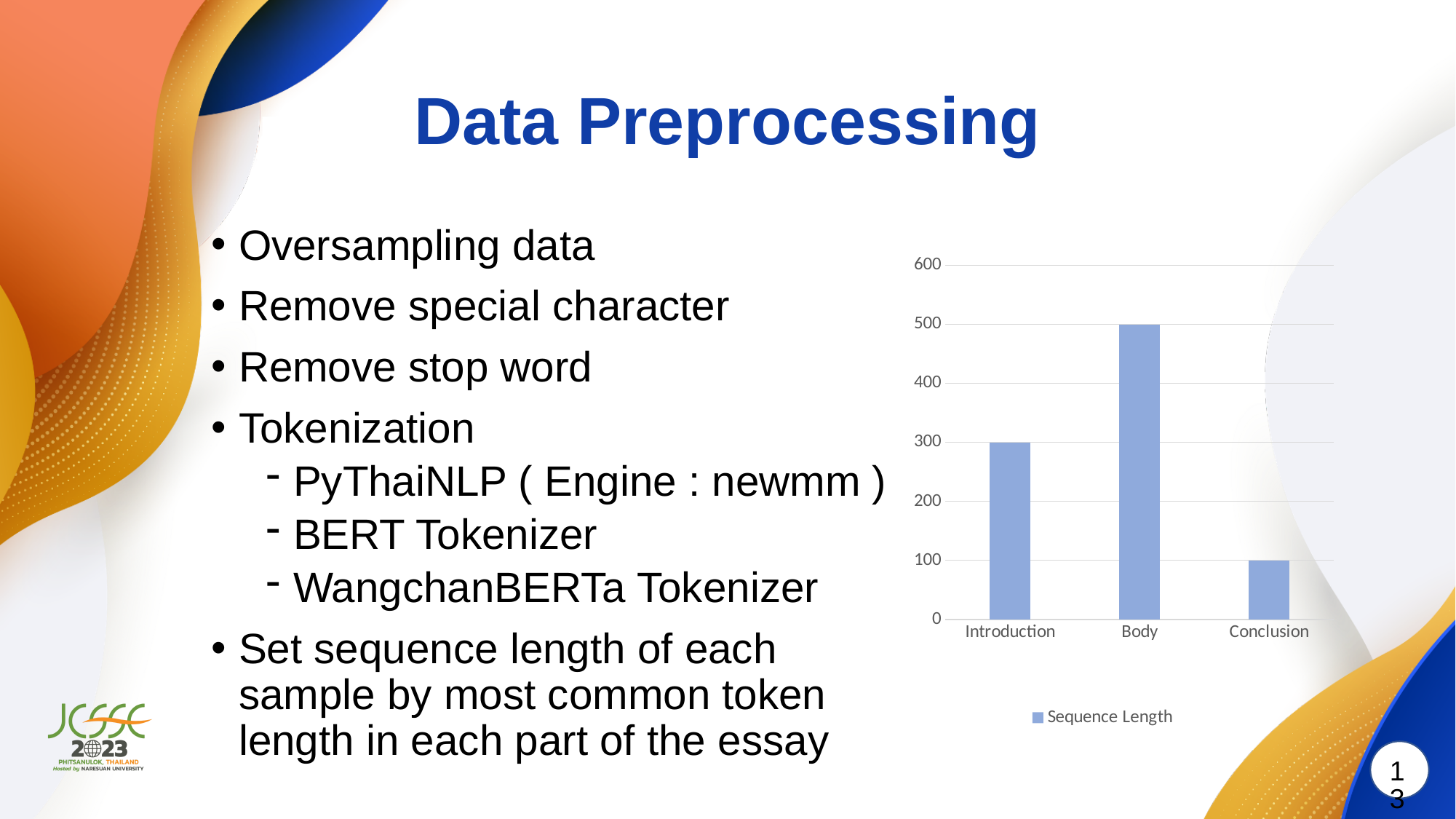
What type of chart is shown on the slide? bar chart Is the sequence length for Body greater or less than 400? greater What is the name of the series shown in the chart legend? Sequence Length What is the sequence length for Introduction? 300 Which part of the essay has the highest sequence length? Body How many series does the chart legend list? 1 What is the sequence length for Conclusion? 100 Which has a larger sequence length, Introduction or Conclusion? Introduction What is the difference in sequence length between Body and Introduction? 200 Which part of the essay has the lowest sequence length? Conclusion What is the sequence length for Body? 500 How many categories are shown on the x axis of the chart? 3